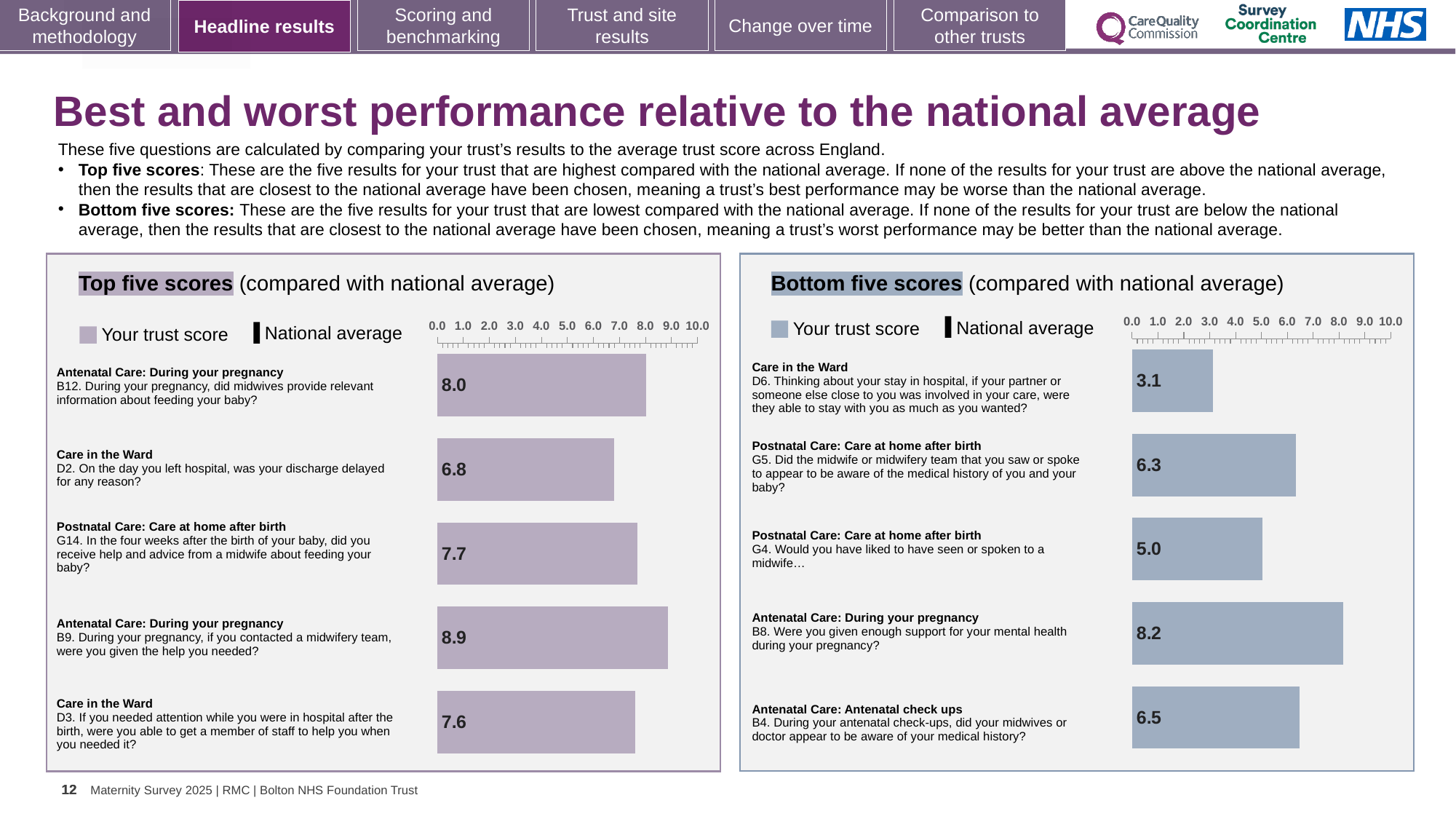
In the 'Top five scores' chart, which question has the highest trust score? B9 (8.9) In the 'Bottom five scores' chart, which question has the lowest trust score? D6 (3.1) In the 'Bottom five scores' chart, which question has the highest trust score? B8 (8.2) In the 'Top five scores' chart, what is the trust score for question G14 about help and advice from a midwife about feeding your baby? 7.7 What type of chart is used in the 'Bottom five scores' panel? Bar chart In the 'Top five scores' chart, what is the difference between the trust scores for B9 and D2? 2.1 In the 'Top five scores' chart, which question has the lowest trust score? D2 (6.8) How many bars are shown in the 'Top five scores' chart? 5 In the 'Bottom five scores' chart, which has the larger trust score: B8 or B4? B8 In the 'Top five scores' chart, what is the trust score for question B9 (During your pregnancy, if you contacted a midwifery team, were you given the help you needed?)? 8.9 In the 'Bottom five scores' chart, what is the difference between the trust scores for B8 and G4? 3.2 In the 'Bottom five scores' chart, what is the trust score for question D6 (Thinking about your stay in hospital, was your partner able to stay with you as much as you wanted?)? 3.1